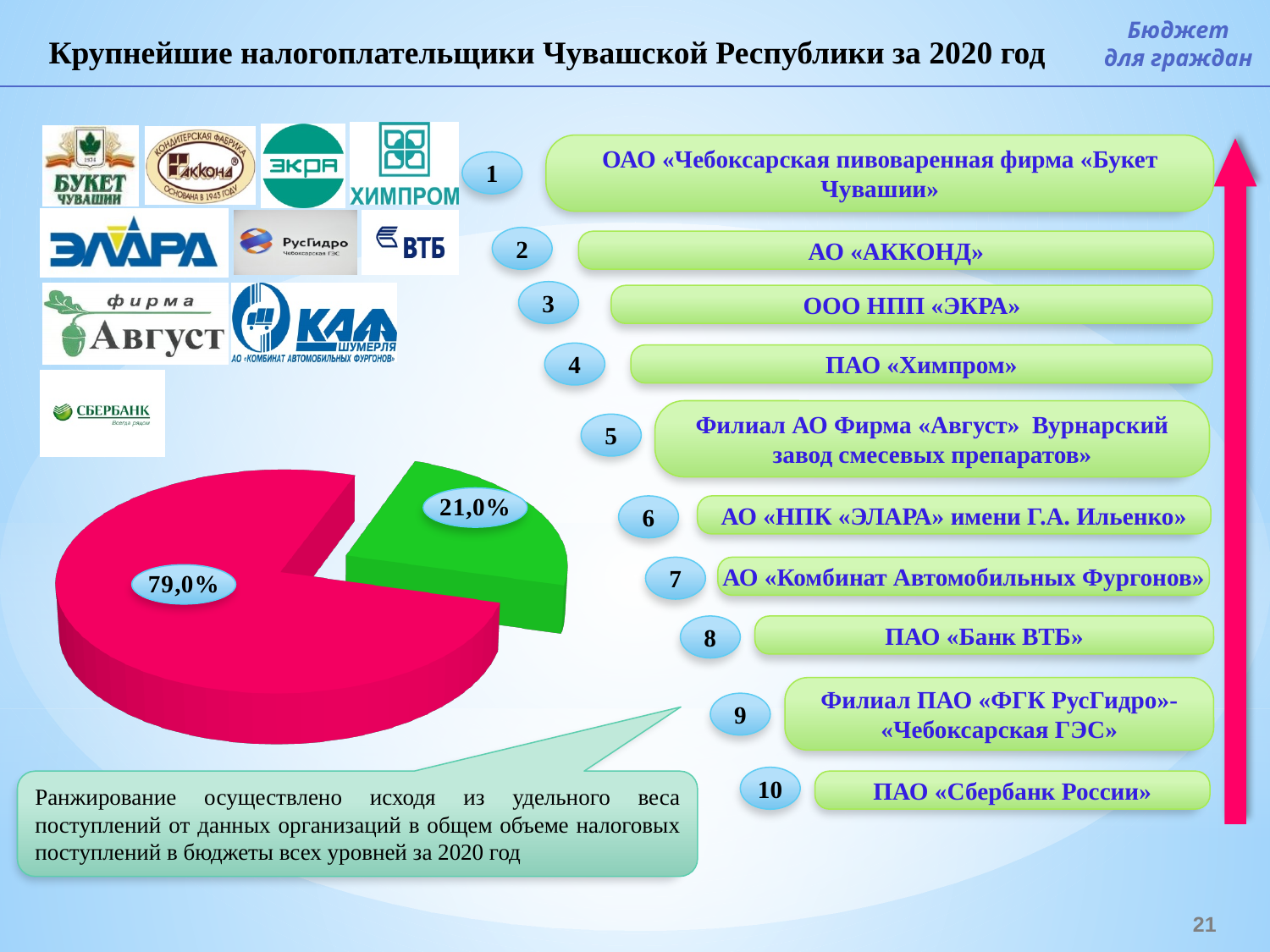
What is the difference between the pink slice and the green slice of the pie chart? 58,0% Which slice of the pie chart is the largest? the pink slice (79,0%) Which slice of the pie chart is the smallest? the green slice (21,0%) What is the total of the two slices shown in the pie chart? 100,0% How many slices does the pie chart have? 2 What kind of chart is shown on the slide? pie chart What colour is the slice labelled 79,0% in the pie chart? pink Which slice of the pie chart is pulled out (exploded) from the rest of the pie? the green slice (21,0%) What value is printed on the pink slice of the pie chart? 79,0% Which is larger in the pie chart, the pink slice or the green slice? the pink slice What value is printed on the green slice of the pie chart? 21,0%